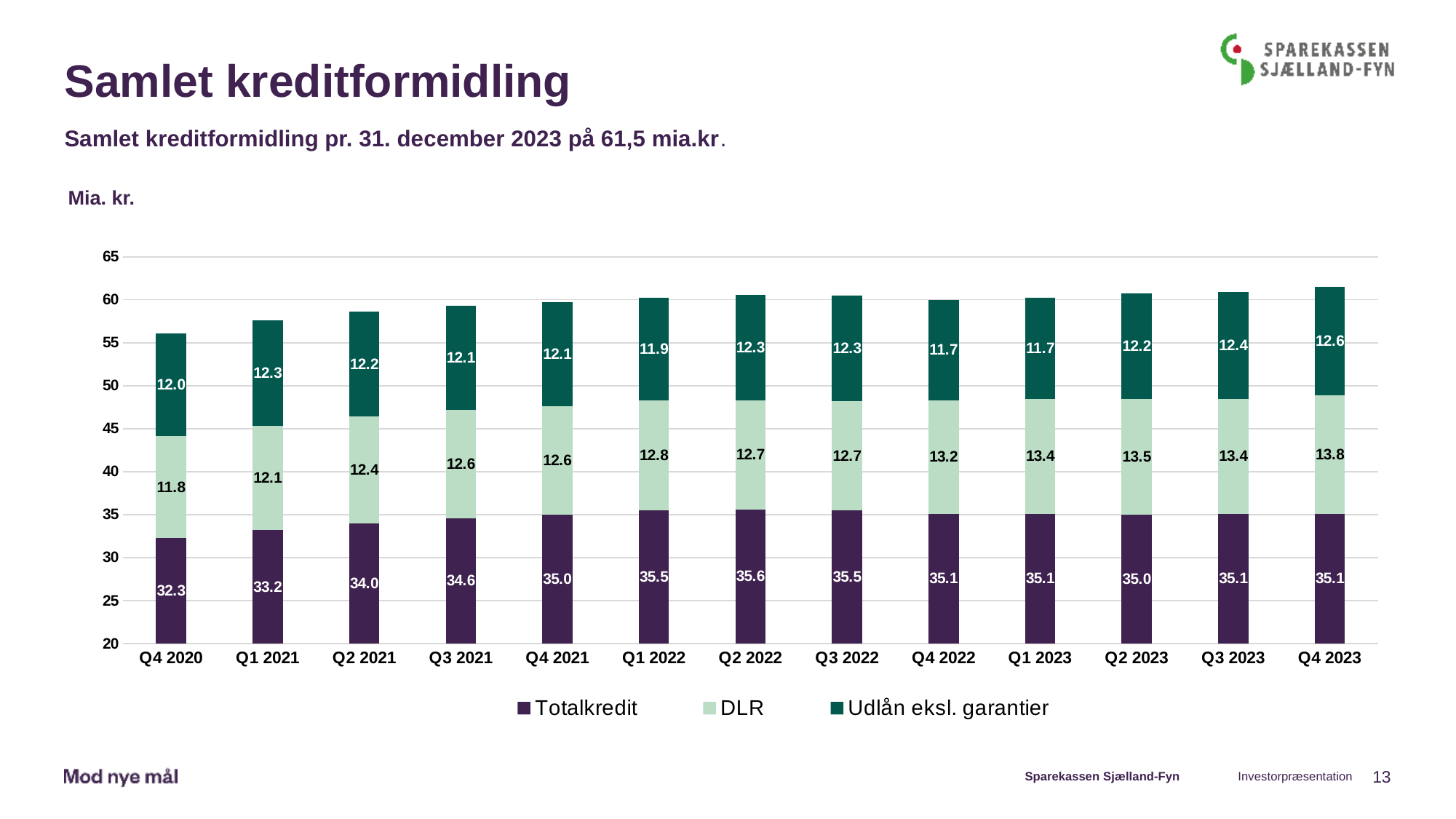
How many quarters are shown on the x axis? 13 In which quarter is the DLR value highest? Q4 2023 In Q1 2023, which is larger: the DLR value or the Udlån eksl. garantier value? DLR In which quarter is the Totalkredit value lowest? Q4 2020 How many series does the legend list? 3 What is the total of the stacked bar for Q4 2023? 61.5 In which quarter is the Totalkredit value highest? Q2 2022 What is the difference between the Totalkredit value in Q4 2023 and in Q4 2020? 2.8 What kind of chart is shown on the slide? Stacked bar chart What is the Totalkredit value for Q4 2023? 35.1 What is the value of Udlån eksl. garantier for Q2 2022? 12.3 What is the DLR value for Q4 2020? 11.8